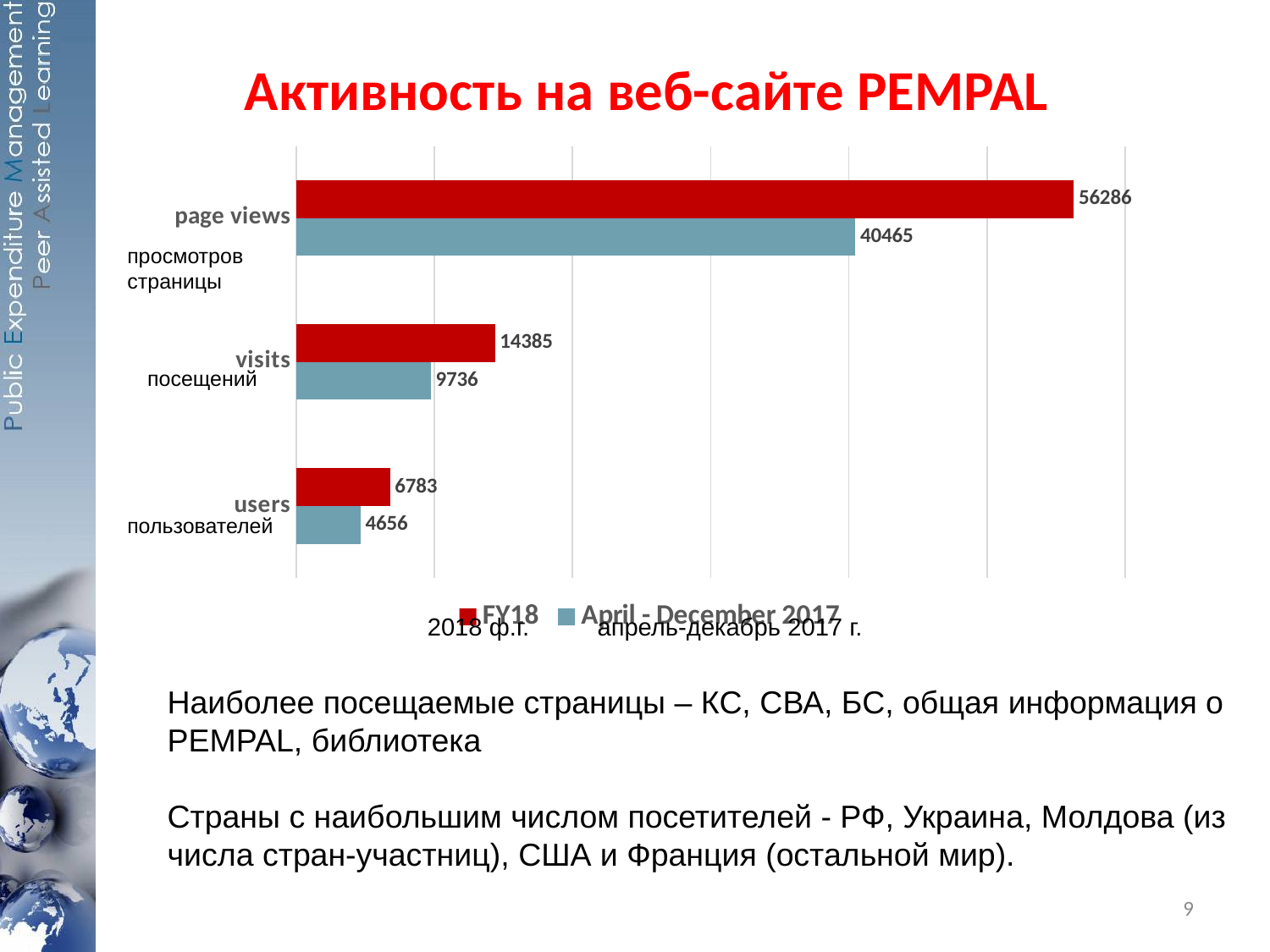
How many series does the legend list? 2 What is the April - December 2017 value for visits? 9736 Which category has the lowest April - December 2017 value? users What is the April - December 2017 value for page views? 40465 What is the FY18 value for page views? 56286 What is the difference between the FY18 and April - December 2017 values for users? 2127 What is the difference between the FY18 and April - December 2017 values for page views? 15821 What kind of chart is shown on the slide? bar chart Which is larger for visits: the FY18 value or the April - December 2017 value? FY18 How many categories are shown on the chart? 3 What is the FY18 value for users? 6783 Which category has the highest FY18 value? page views